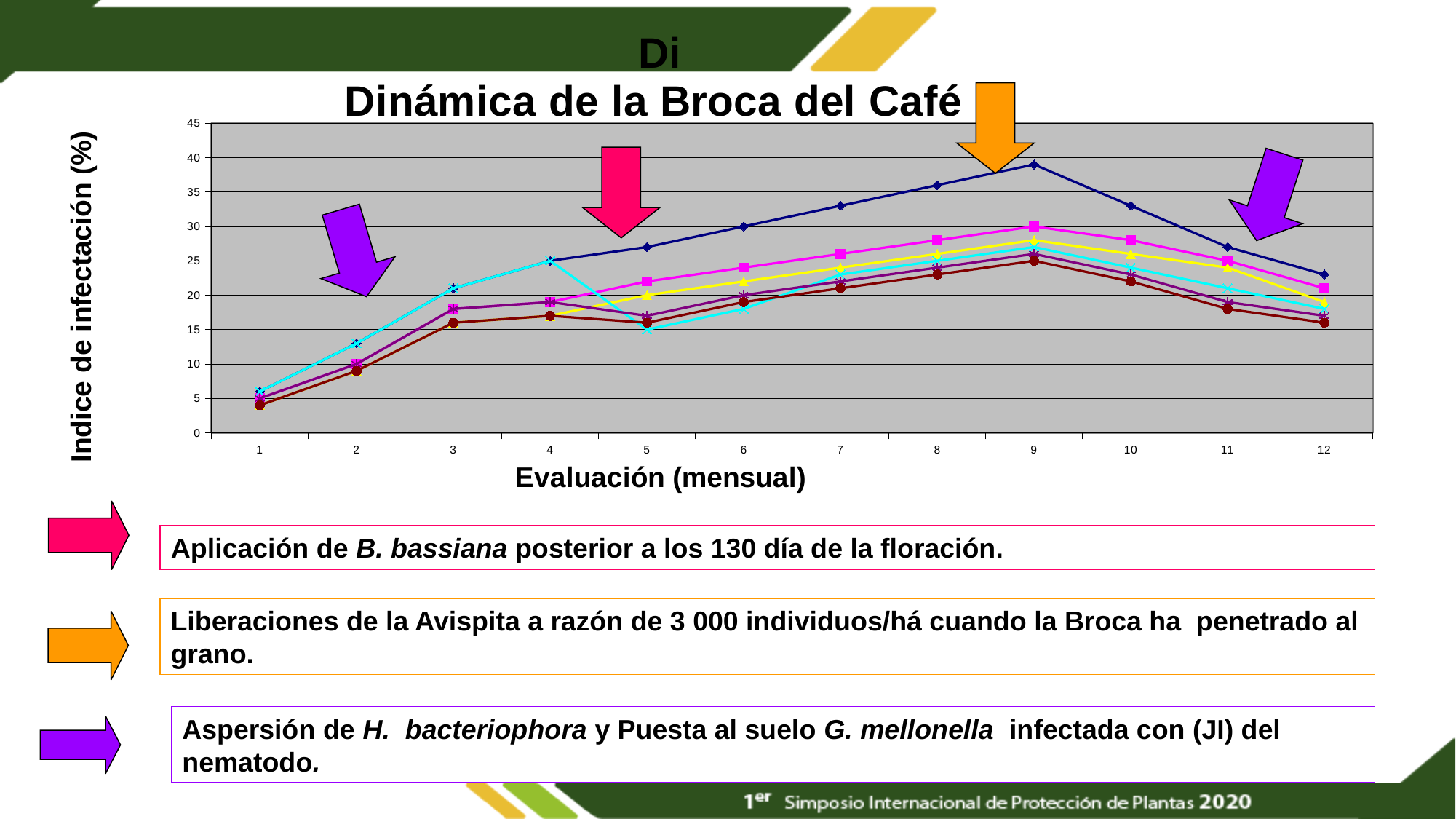
What is the value of the magenta line at evaluation 9? 30 What is the value of the cyan line at evaluation 4? 25 What is the title of the chart? Dinámica de la Broca del Café Is the value of the dark red line at evaluation 1 greater or less than 10? less How many evaluation points are shown along the x axis? 12 Is the value of the dark blue line at evaluation 9 greater or less than 35? greater What kind of chart is shown on the slide? Line chart Does the dark blue line rise or fall between evaluation 9 and evaluation 12? Falls At which evaluation does the dark blue line reach its highest value? 9 What is the label of the y axis? Indice de infectación (%) Which line has the highest value at evaluation 9? The dark blue line What is the value of the dark blue line at evaluation 6? 30